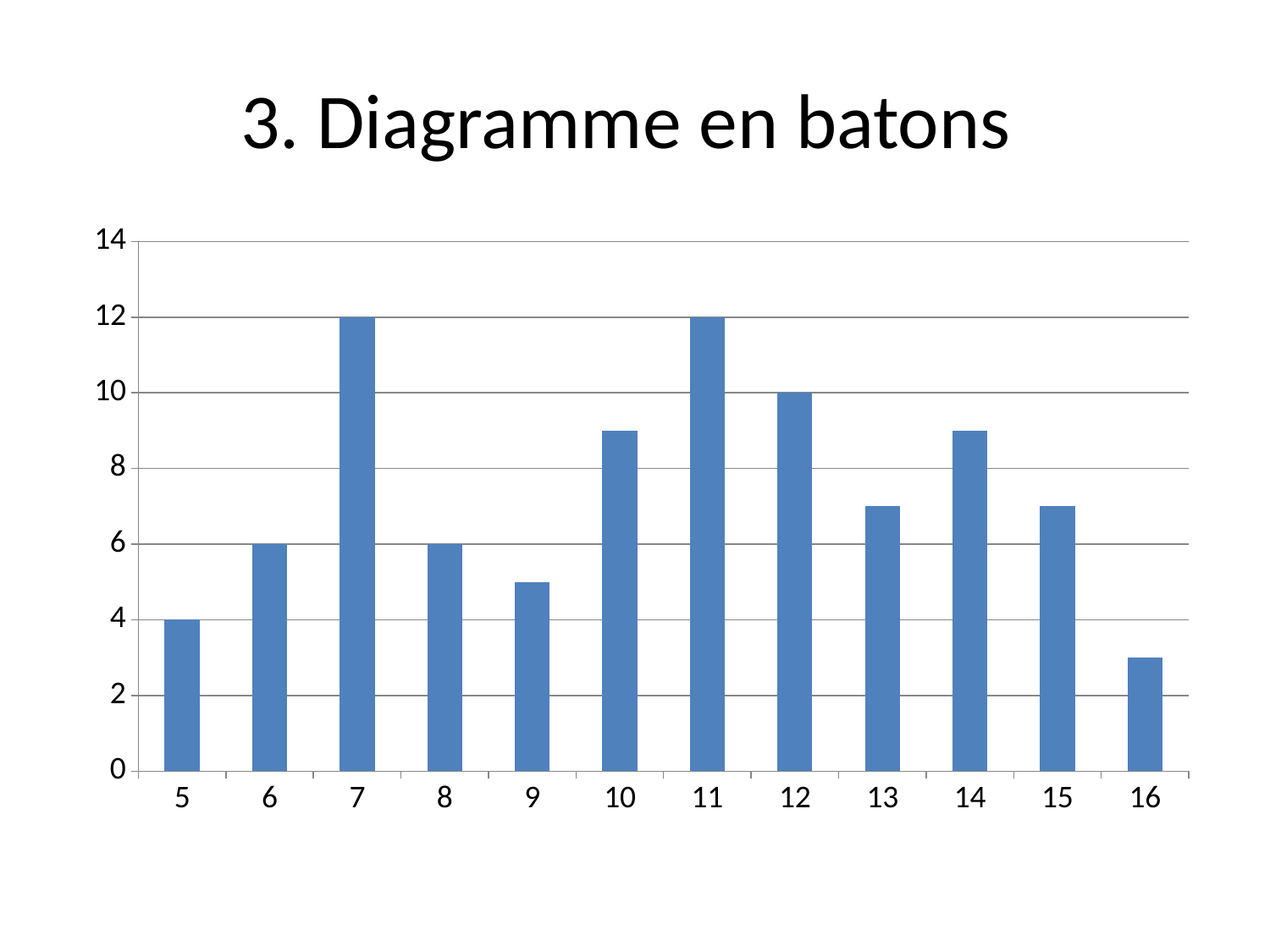
What is the title of the slide? 3. Diagramme en batons What kind of chart is shown on the slide? bar chart How many categories are shown on the x axis? 12 What is the value for category 7? 12 Which category has the lowest value? 16 What is the value for category 12? 10 What is the value for category 5? 4 Is the value for category 10 greater or less than 8? greater What is the value for category 8? 6 What is the difference between the values for category 7 and category 12? 2 Which has the larger value, category 12 or category 13? 12 Is the value for category 16 greater or less than 4? less